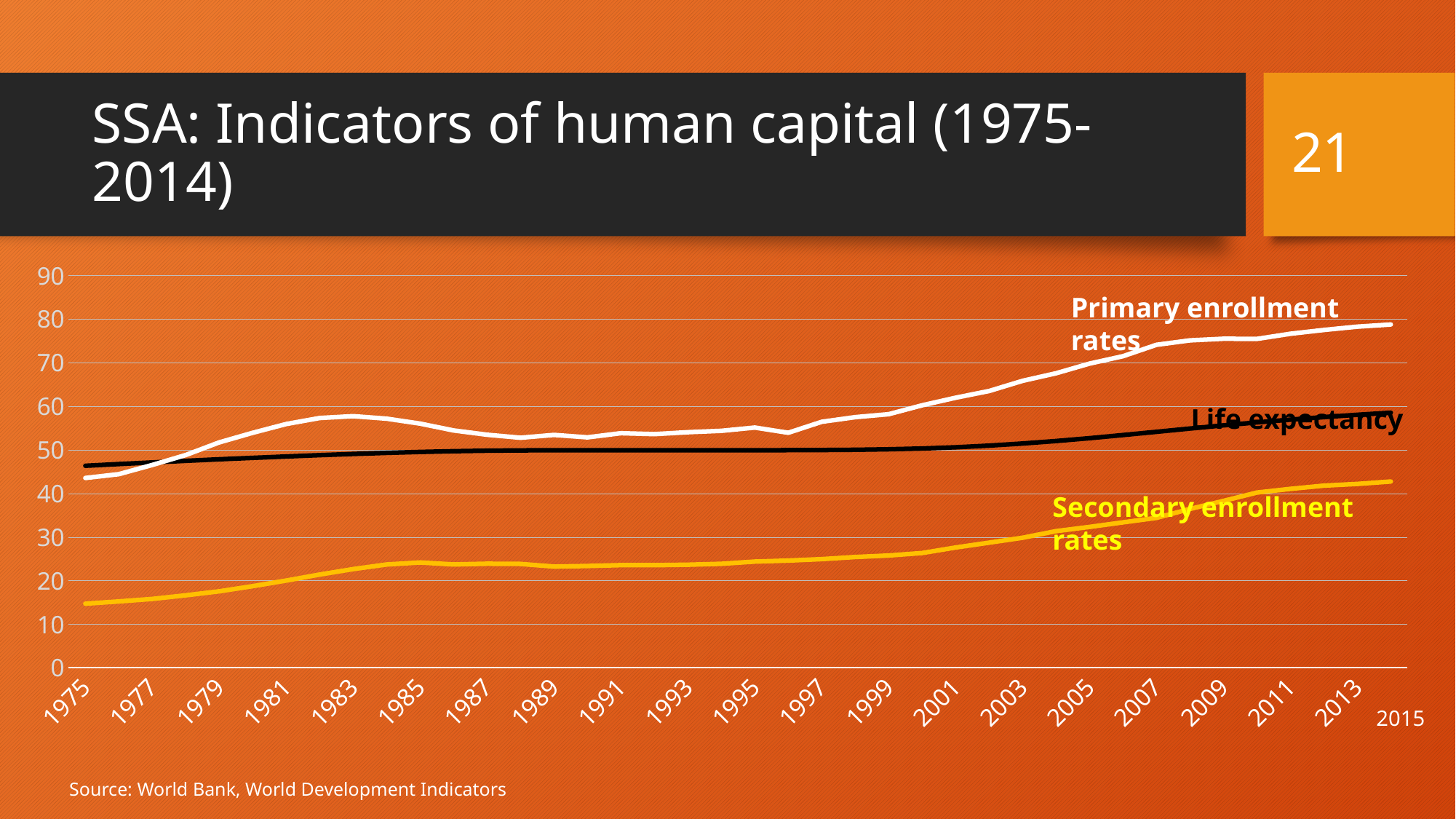
Which series has the lowest value in 2013? Secondary enrollment rates Which series has the highest value in 2013? Primary enrollment rates In 2013, which is larger: Life expectancy or Secondary enrollment rates? Life expectancy In 1983, which is larger: Primary enrollment rates or Life expectancy? Primary enrollment rates Is the value for Primary enrollment rates in 1975 greater or less than 50? less What kind of chart is shown on the slide? Line chart Is the value for Secondary enrollment rates in 1975 greater or less than 20? less Does the Secondary enrollment rates line rise or fall overall from 1975 to 2014? Rise Is the value for Primary enrollment rates in 2013 greater or less than 70? greater How many series are plotted on the chart? 3 What is the title of the chart slide? SSA: Indicators of human capital (1975-2014)